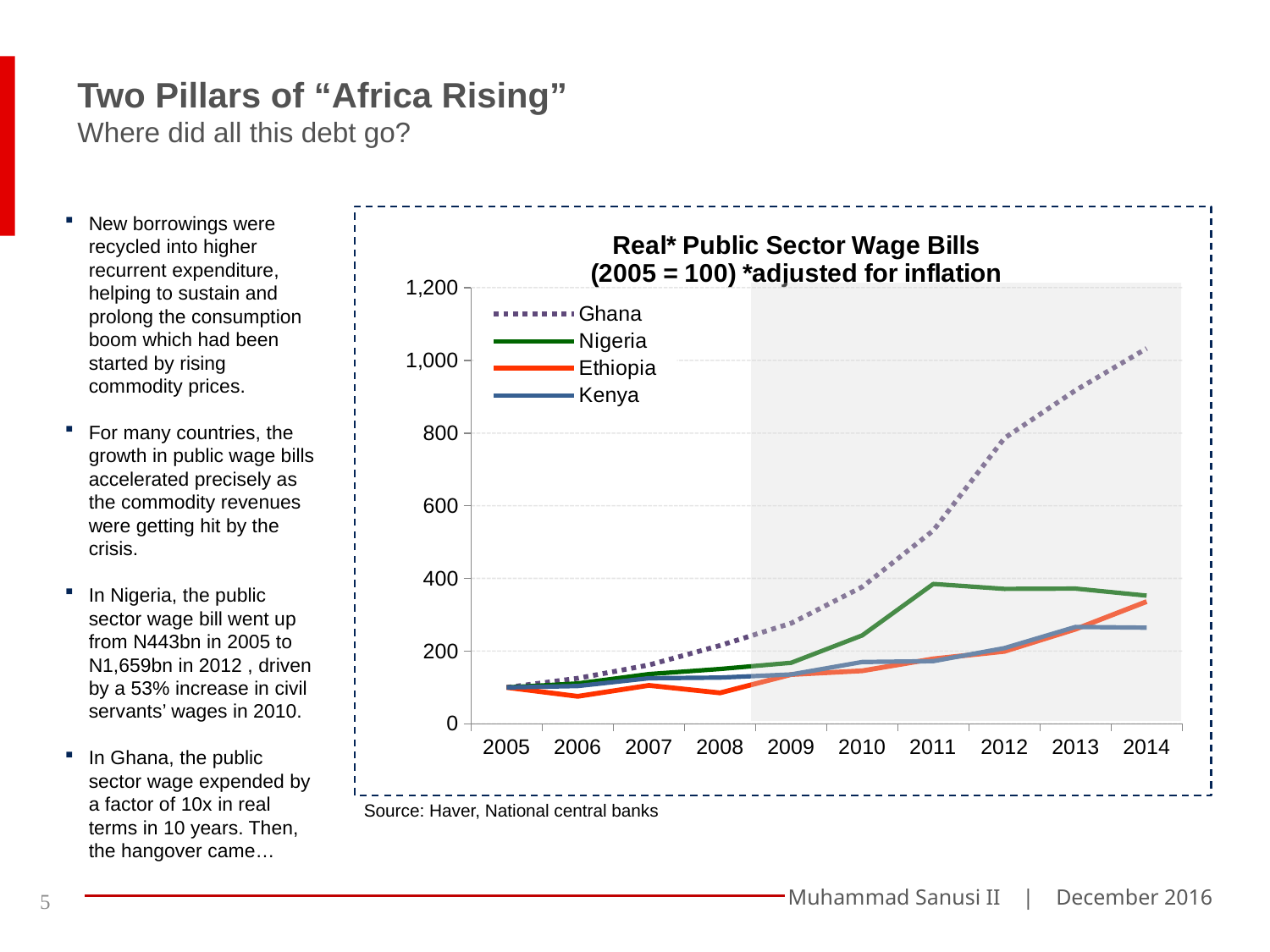
Does the Ghana series rise or fall from 2005 to 2014? rise Which series in the chart is drawn with a dotted line? Ghana In 2011, which is larger, the value for Nigeria or the value for Kenya? Nigeria Is the value for Ethiopia in 2006 greater or less than 100? less Is the value for Nigeria in 2011 greater or less than 200? greater Is the value for Ghana in 2014 greater or less than 800? greater Which country has the highest real public sector wage bill index in 2014? Ghana Which country has the lowest real public sector wage bill index in 2014? Kenya How many years are shown along the x axis of the chart? 10 What kind of chart is shown on the slide? line chart How many series does the chart's legend list? 4